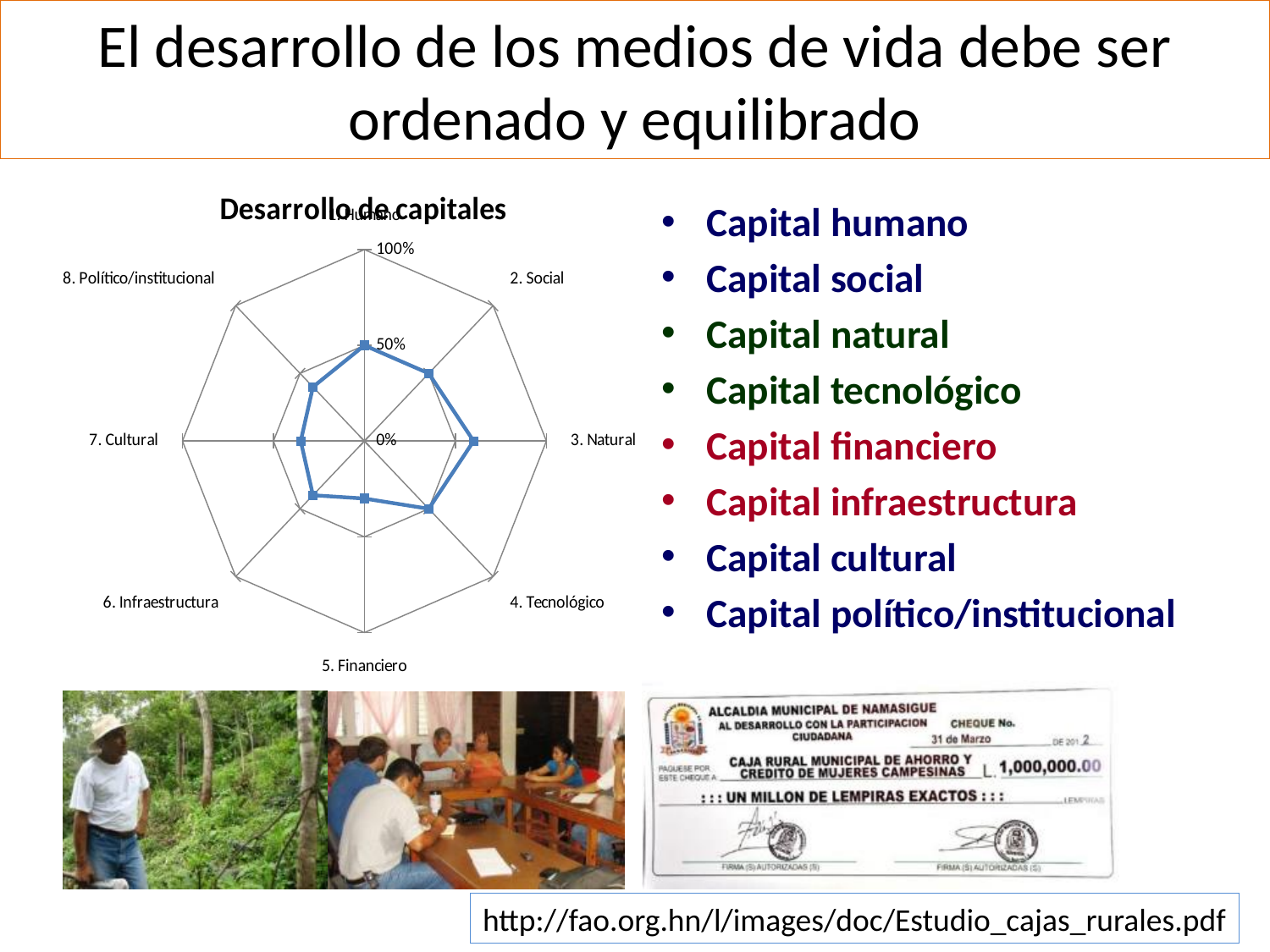
What kind of chart is shown on the slide? radar chart Is the value for 4. Tecnológico greater or less than 100%? less Is the value for 8. Político/institucional greater or less than 50%? less What is the title of the chart? Desarrollo de capitales Is the value for 5. Financiero greater or less than 50%? less Which category has the highest value on the radar chart? 3. Natural Which is larger, the value for 2. Social or the value for 7. Cultural? 2. Social Which is larger, the value for 3. Natural or the value for 5. Financiero? 3. Natural How many categories (capitals) are plotted on the radar chart? 8 What is the maximum value shown on the chart's axis scale? 100%